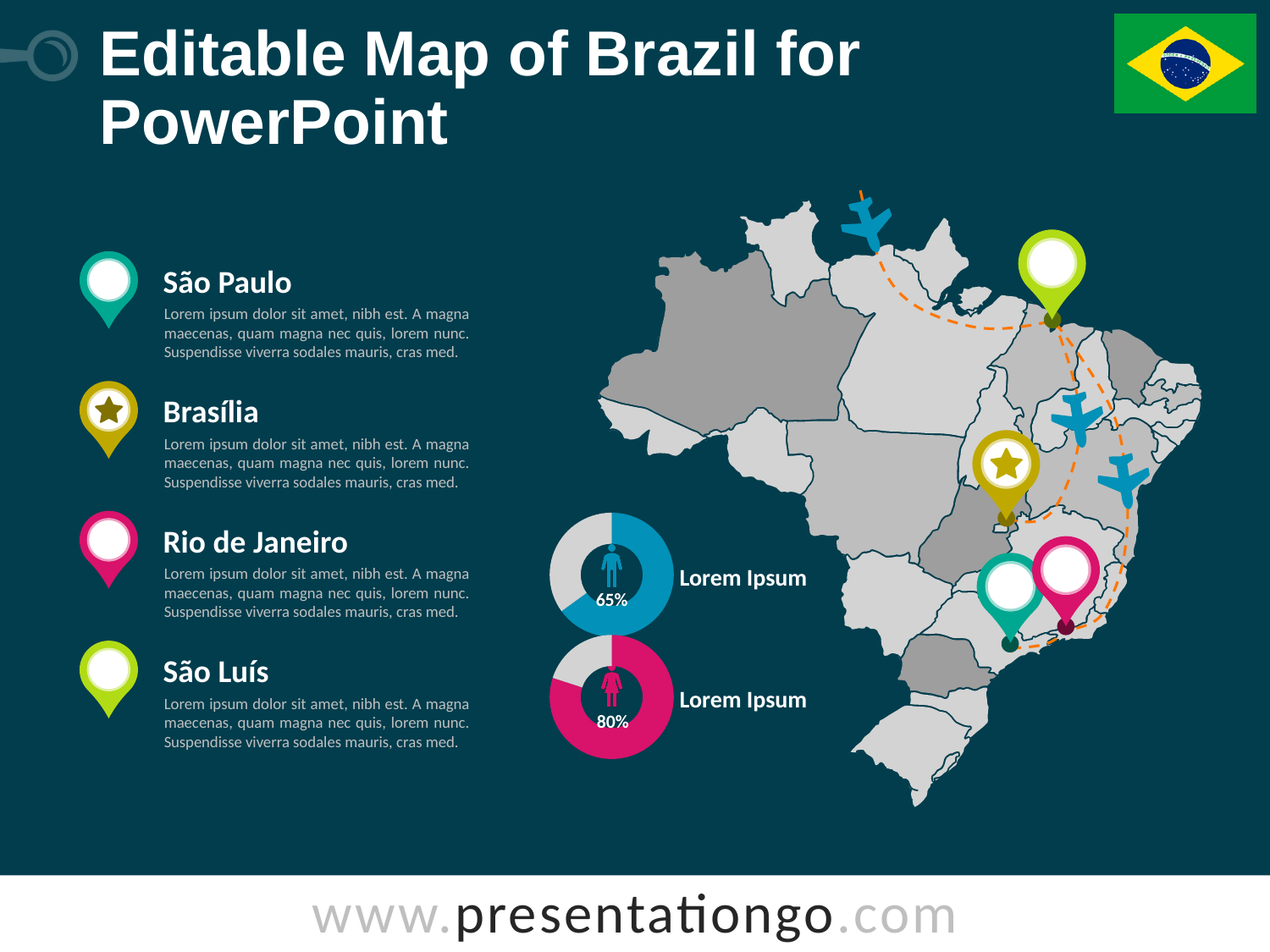
What share of the upper blue donut chart is left unfilled (grey)? 35% What is the difference between the value on the lower pink donut chart and the value on the upper blue donut chart? 15 percentage points Is the value on the lower pink donut chart greater or less than 75%? greater What share of the lower pink donut chart is left unfilled (grey)? 20% What kind of charts are the two circular graphics to the left of the map? donut charts What text label is placed to the right of each donut chart? Lorem Ipsum What percentage is shown on the upper (blue) donut chart next to the map? 65% How many donut charts are shown on the slide? 2 Which of the two donut charts shows the larger value, the upper blue one or the lower pink one? the lower pink one (80%) Is the value on the upper blue donut chart greater or less than 50%? greater What percentage is shown on the lower (pink) donut chart next to the map? 80% What icon appears in the centre of the upper blue donut chart? a male figure